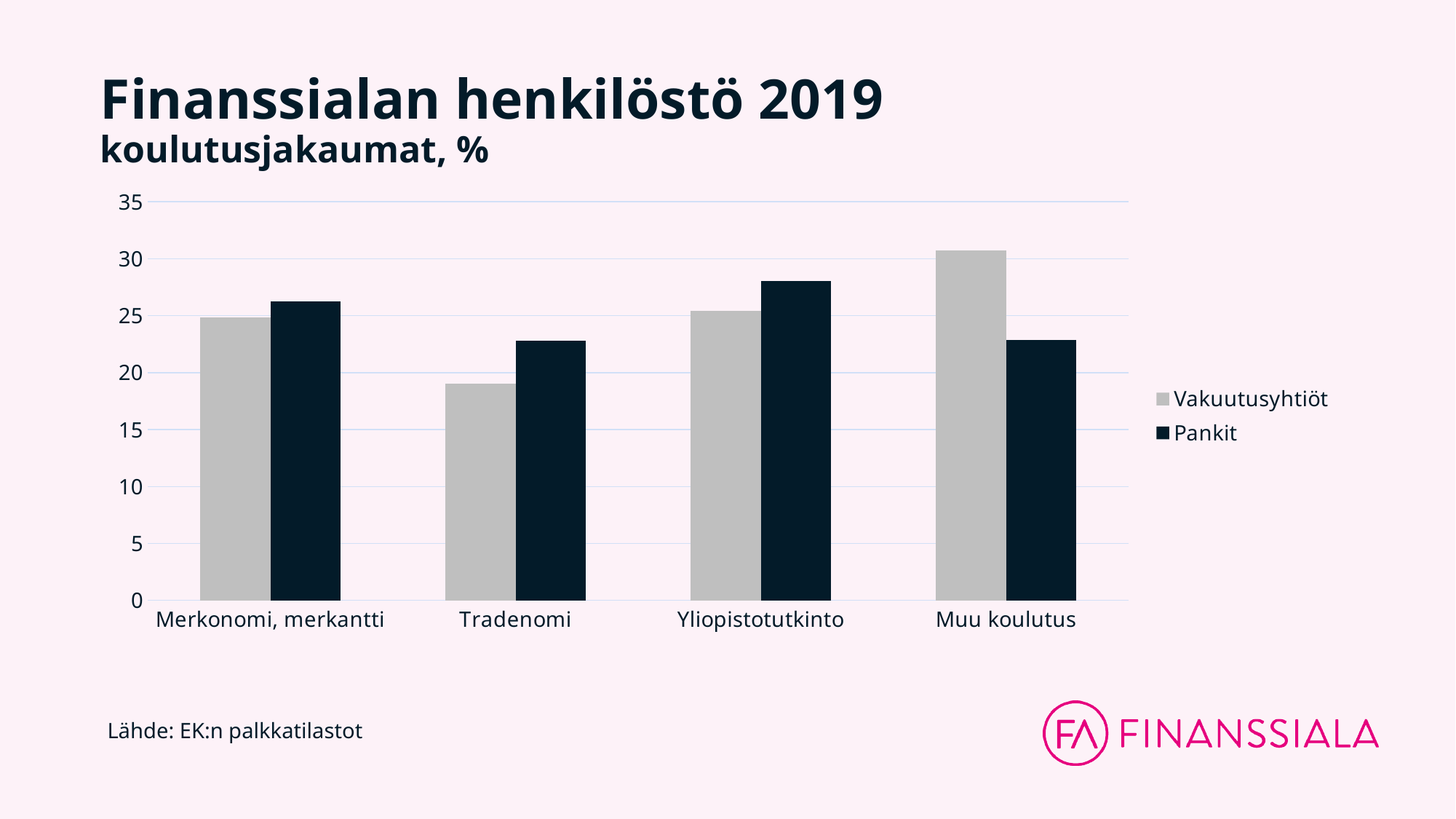
Is the Pankit value for Yliopistotutkinto greater or less than 25? greater For Muu koulutus, which series has the larger value, Vakuutusyhtiöt or Pankit? Vakuutusyhtiöt Which category has the highest value for Pankit? Yliopistotutkinto Which category has the lowest value for Vakuutusyhtiöt? Tradenomi How many series does the legend list? 2 Is the Vakuutusyhtiöt value for Tradenomi greater or less than 20? less What are the two series named in the legend? Vakuutusyhtiöt and Pankit Which category has the highest value for Vakuutusyhtiöt? Muu koulutus What kind of chart is shown on the slide? bar chart For Yliopistotutkinto, which series has the larger value, Vakuutusyhtiöt or Pankit? Pankit Is the Pankit value for Tradenomi greater or less than 20? greater How many education categories are shown on the x axis? 4